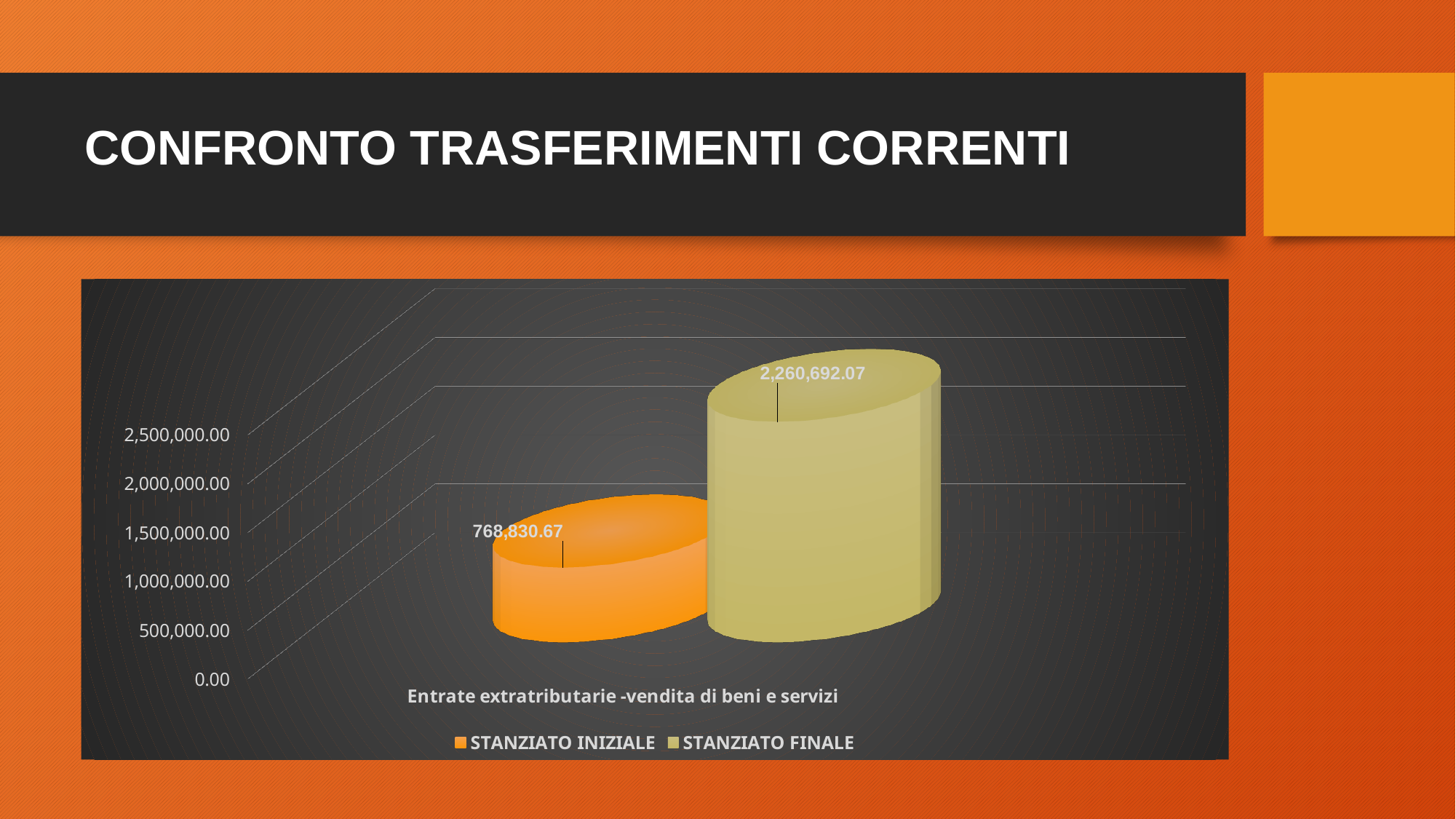
Is the value for STANZIATO FINALE greater or less than 2,000,000.00? greater Which series has the lowest value on the chart? STANZIATO INIZIALE Which series has the higher value, STANZIATO INIZIALE or STANZIATO FINALE? STANZIATO FINALE What colour is the STANZIATO INIZIALE series? Orange How many categories are shown on the x axis? 1 How many series does the legend list? 2 What kind of chart is shown on the slide? Bar chart What is the title of the slide? CONFRONTO TRASFERIMENTI CORRENTI Is the value for STANZIATO INIZIALE greater or less than 1,000,000.00? less What is the value of STANZIATO FINALE for Entrate extratributarie -vendita di beni e servizi? 2,260,692.07 What is the difference between STANZIATO FINALE and STANZIATO INIZIALE? 1,491,861.40 What is the value of STANZIATO INIZIALE for Entrate extratributarie -vendita di beni e servizi? 768,830.67